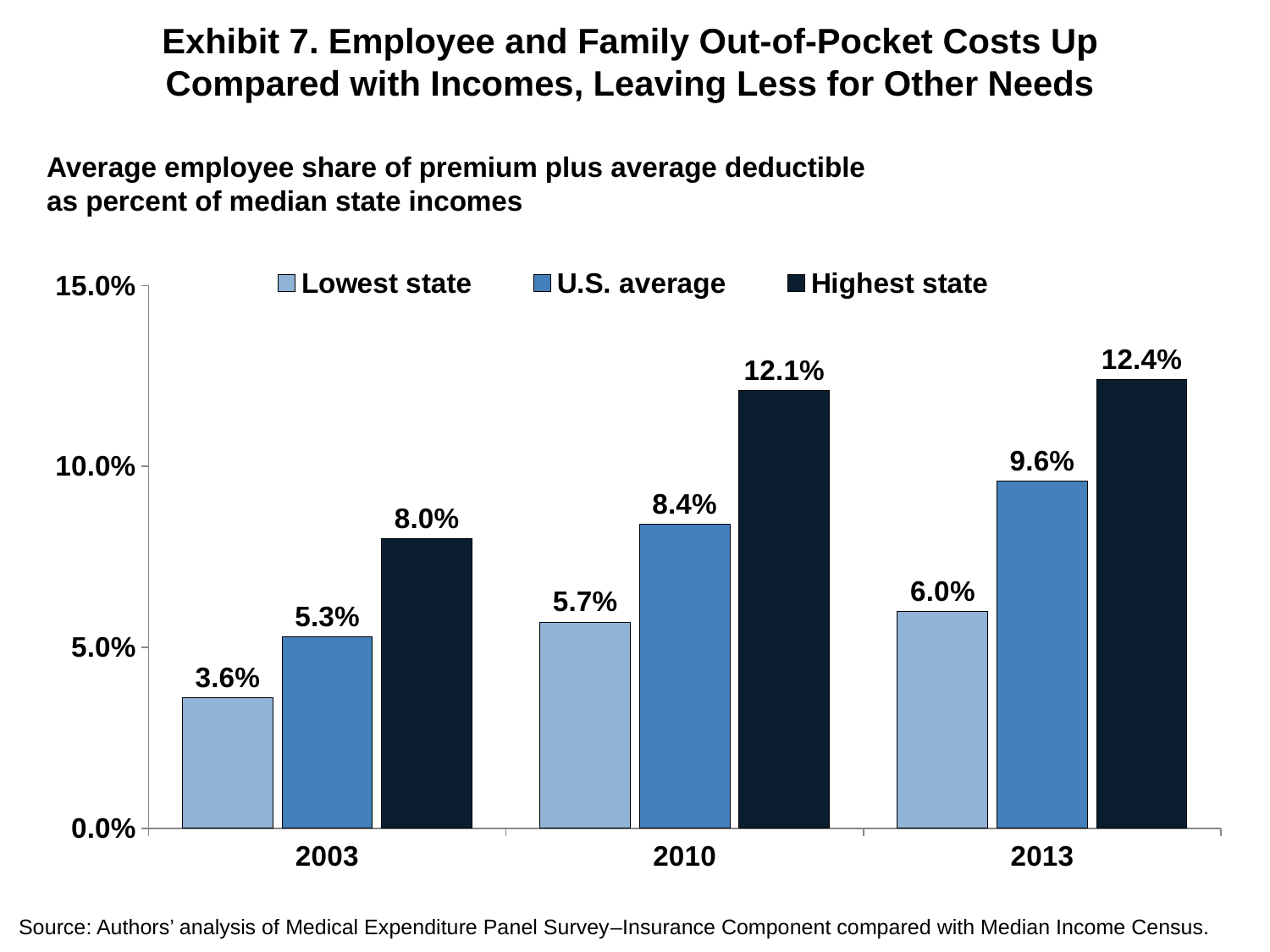
What is the value for the Lowest state in 2013? 6.0% In which year is the Lowest state value the smallest? 2003 What is the difference between the Highest state and Lowest state values in 2013? 6.4% What kind of chart is shown? Bar chart In which year is the Highest state value the largest? 2013 What is the value for the U.S. average in 2010? 8.4% How many series does the legend list? 3 Which is larger: the U.S. average in 2010 or the Highest state in 2003? U.S. average in 2010 How many years are shown on the x axis? 3 Does the U.S. average rise or fall from 2003 to 2013? Rise What is the value for the Highest state in 2003? 8.0% What is the difference between the U.S. average in 2013 and in 2003? 4.3%